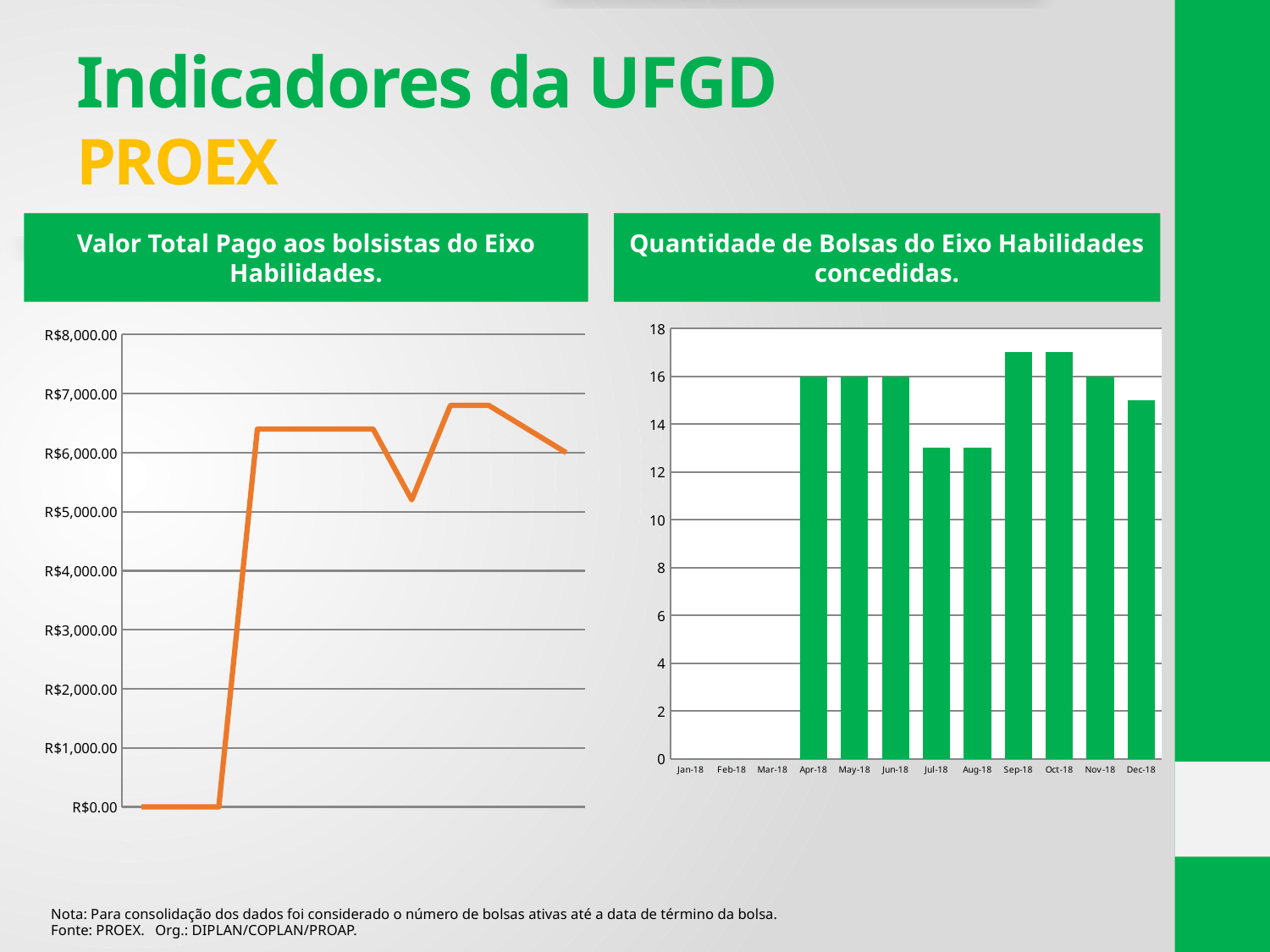
On the chart titled "Quantidade de Bolsas do Eixo Habilidades concedidas.", which is larger, the value for May-18 or the value for Aug-18? May-18 On the chart titled "Quantidade de Bolsas do Eixo Habilidades concedidas.", what is the value for Apr-18? 16 What kind of chart is the one titled "Valor Total Pago aos bolsistas do Eixo Habilidades."? line chart On the chart titled "Quantidade de Bolsas do Eixo Habilidades concedidas.", how many months are shown on the x axis? 12 On the chart titled "Quantidade de Bolsas do Eixo Habilidades concedidas.", is the value for Dec-18 greater or less than 14? greater What kind of chart is the one titled "Quantidade de Bolsas do Eixo Habilidades concedidas."? bar chart On the chart titled "Valor Total Pago aos bolsistas do Eixo Habilidades.", what is the lowest value the line reaches? R$0.00 On the chart titled "Valor Total Pago aos bolsistas do Eixo Habilidades.", is the highest value on the line greater or less than R$6,000.00? greater On the chart titled "Quantidade de Bolsas do Eixo Habilidades concedidas.", what is the value for Nov-18? 16 On the chart titled "Quantidade de Bolsas do Eixo Habilidades concedidas.", is the value for Jul-18 greater or less than 14? less On the chart titled "Quantidade de Bolsas do Eixo Habilidades concedidas.", what is the difference between the values for Apr-18 and Jan-18? 16